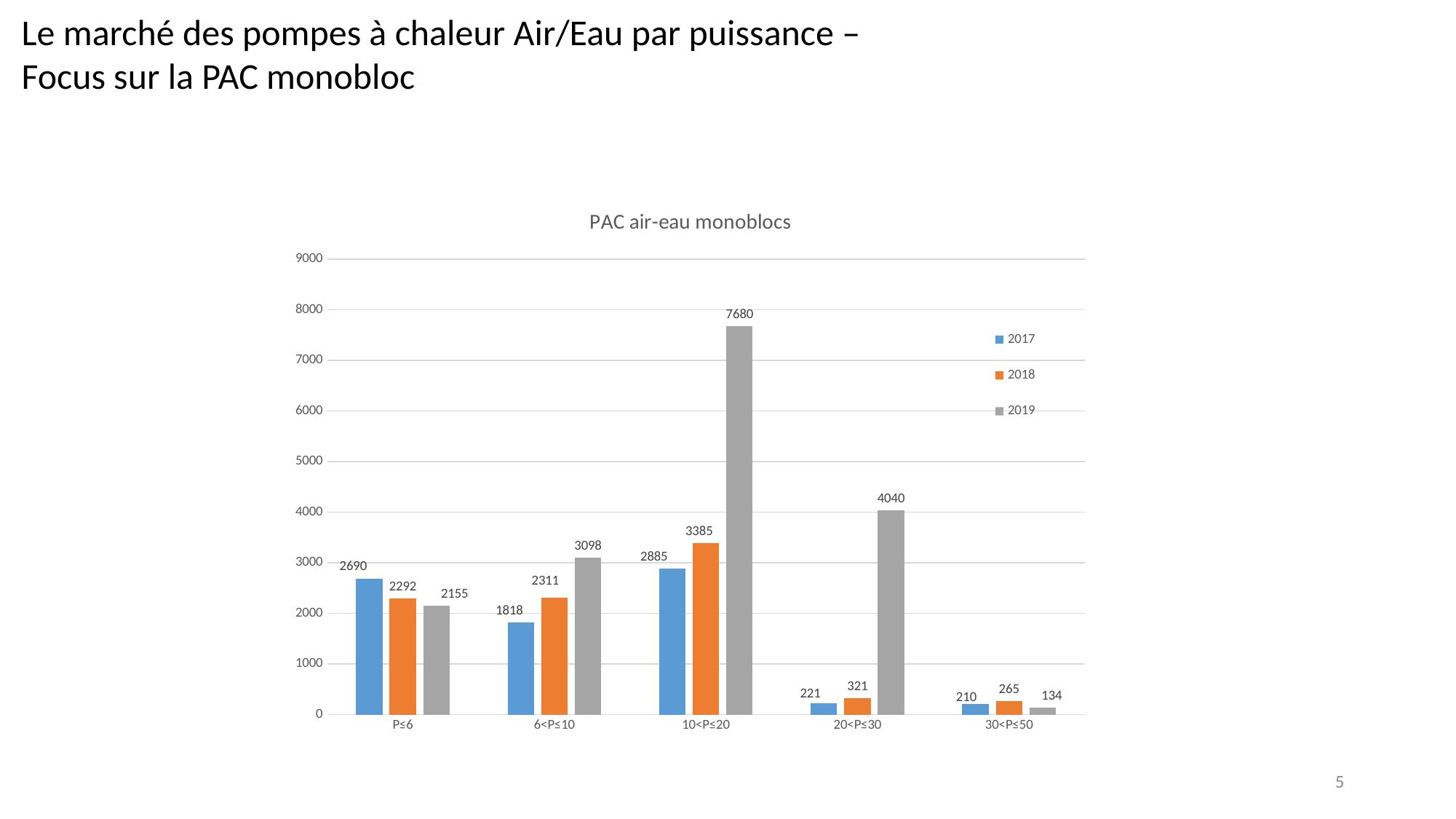
What is the title of the chart? PAC air-eau monoblocs What is the difference between the 2019 and 2017 values in the 10<P≤20 category? 4795 Is the value for 2019 in the 20<P≤30 category greater or less than 3000? greater How many power categories are shown on the x axis? 5 What is the value for 2018 in the 30<P≤50 category? 265 Which category has the lowest value for 2017? 30<P≤50 Which is larger in the 6<P≤10 category: the 2017 value or the 2018 value? 2018 What is the value for 2017 in the P≤6 category? 2690 What is the value for 2019 in the 10<P≤20 category? 7680 How many series does the legend list? 3 Which category has the highest value for 2019? 10<P≤20 What kind of chart is shown on the slide? bar chart